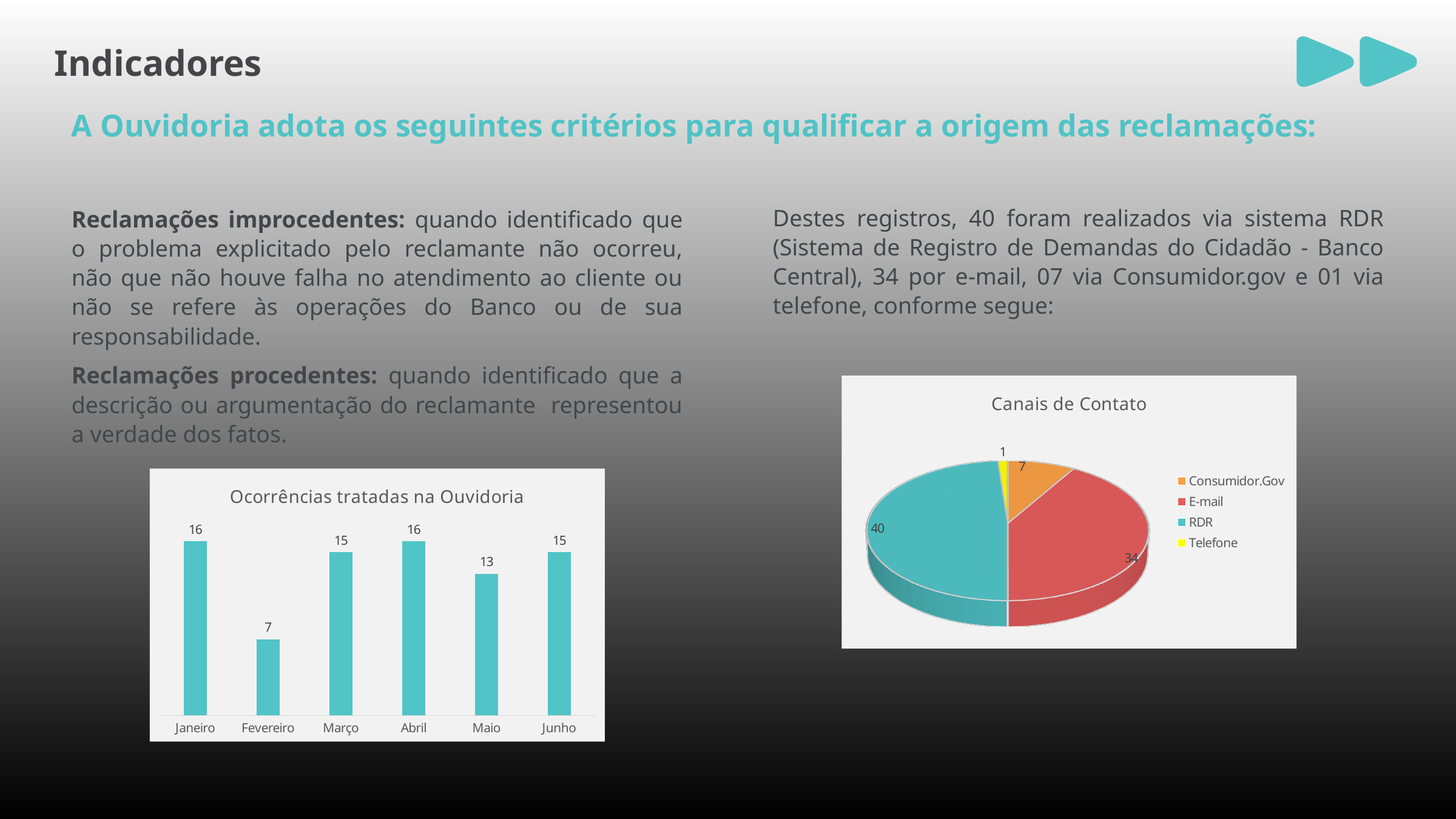
How many entries does the legend of the chart titled "Canais de Contato" list? 4 In the chart titled "Ocorrências tratadas na Ouvidoria", which is larger, the value for Março or the value for Maio? Março In the chart titled "Canais de Contato", which channel has the smallest slice? Telefone In the chart titled "Ocorrências tratadas na Ouvidoria", what is the difference between the values for Janeiro and Fevereiro? 9 What kind of chart is "Ocorrências tratadas na Ouvidoria"? Bar chart How many months are shown in the chart titled "Ocorrências tratadas na Ouvidoria"? 6 In the chart titled "Canais de Contato", what is the value for E-mail? 34 In the chart titled "Ocorrências tratadas na Ouvidoria", what is the value for Fevereiro? 7 In the chart titled "Canais de Contato", which channel has the largest slice? RDR In the chart titled "Canais de Contato", what is the difference between the values for RDR and Consumidor.Gov? 33 In the chart titled "Ocorrências tratadas na Ouvidoria", which month has the lowest value? Fevereiro In the chart titled "Ocorrências tratadas na Ouvidoria", what is the value for Maio? 13